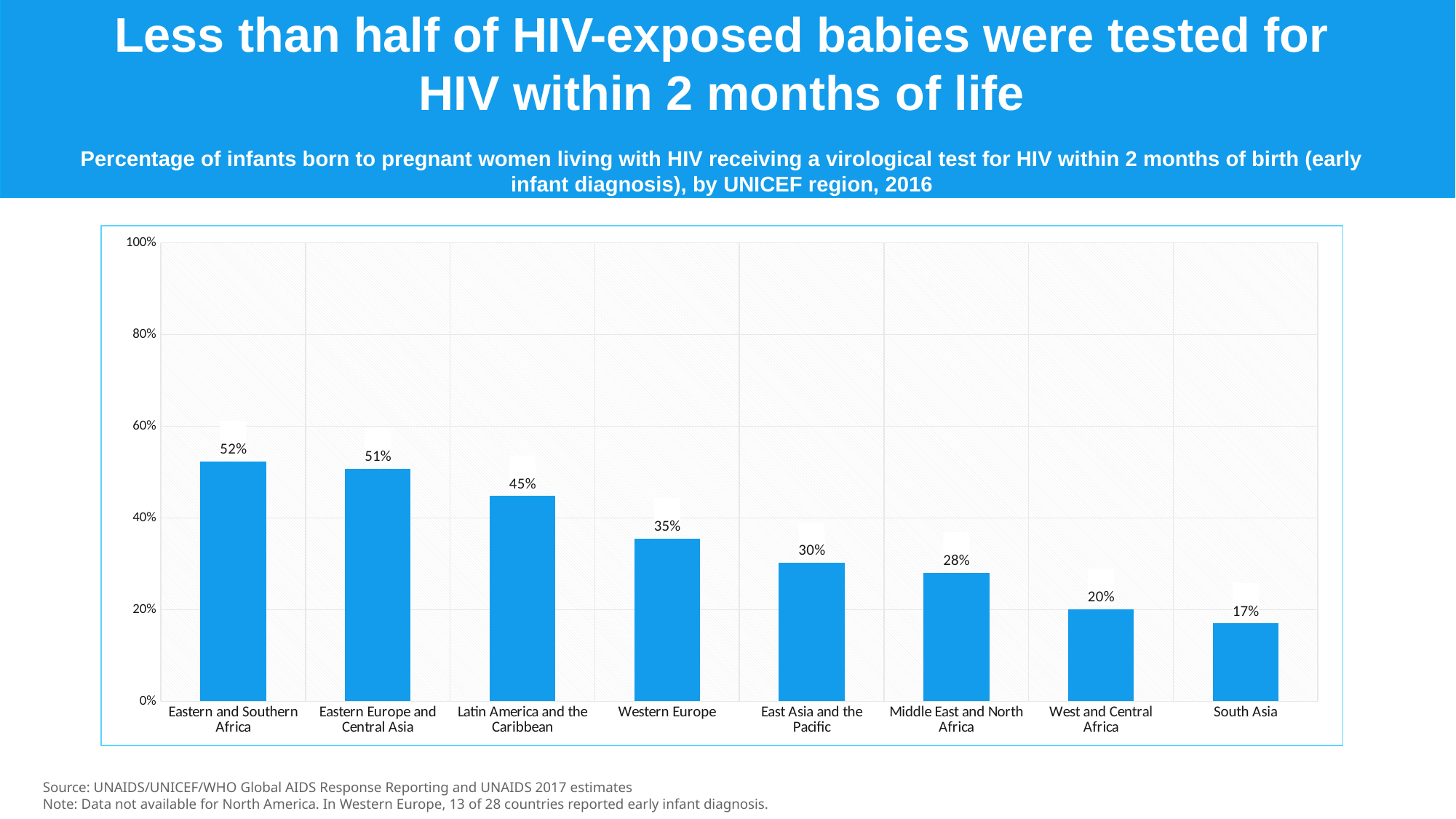
What kind of chart is shown on the slide? Bar chart Do the values rise or fall from left to right along the x axis? Fall Which is larger, the value for West and Central Africa or the value for Middle East and North Africa? Middle East and North Africa What is the difference between the values for Eastern Europe and Central Asia and South Asia? 34% What is the value for Eastern and Southern Africa? 52% What is the value for Western Europe? 35% What is the value for South Asia? 17% How many regions are shown in the chart? 8 Which region has the lowest value? South Asia What is the difference between the values for Latin America and the Caribbean and East Asia and the Pacific? 15% What is the value for Middle East and North Africa? 28% Which region has the highest value? Eastern and Southern Africa